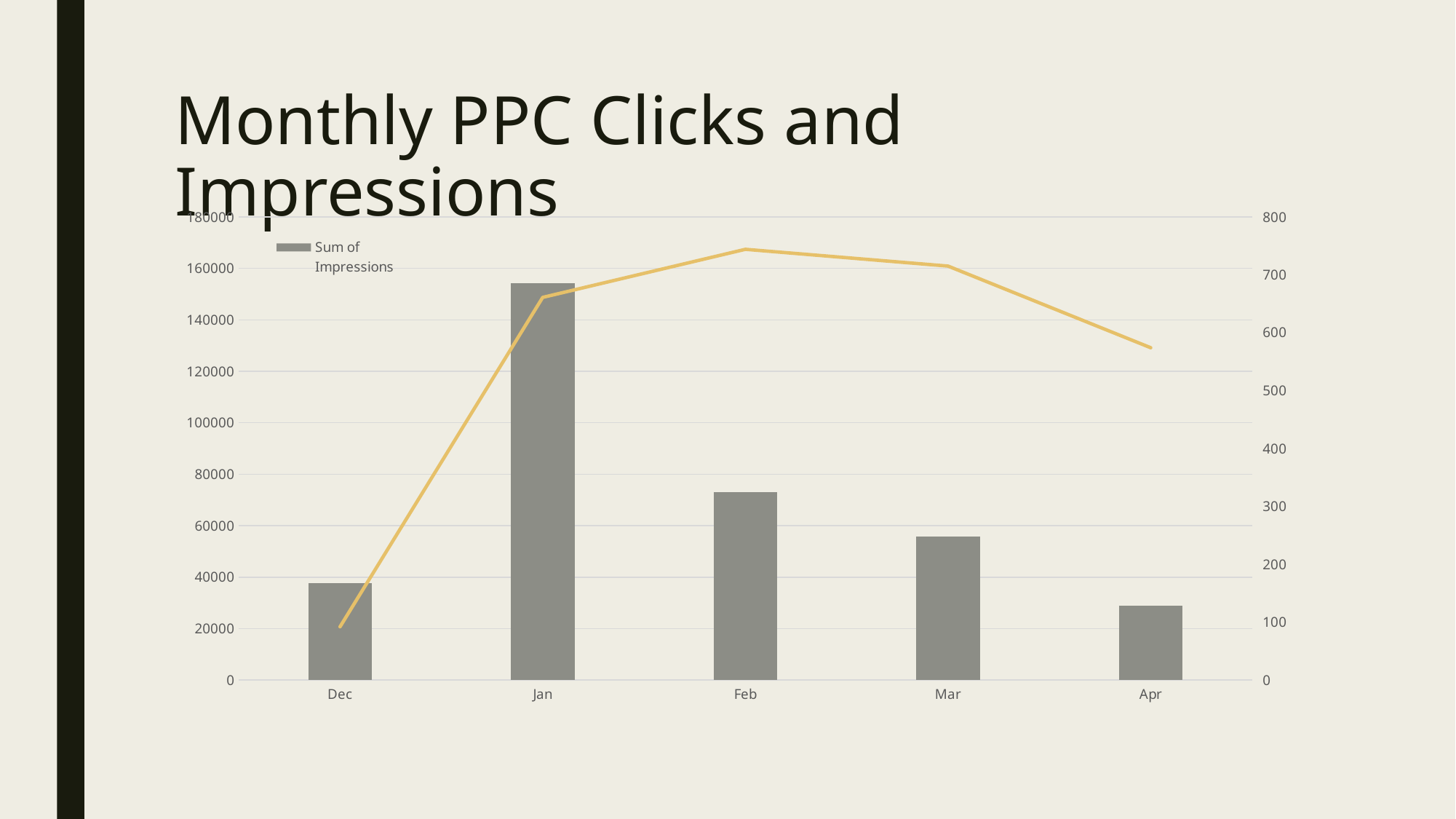
Which month has the lowest Sum of Impressions? Apr Is the Sum of Impressions for Feb greater or less than 80000? less Is the Sum of Impressions for Mar greater or less than 60000? less What kind of chart is shown on the slide? A bar chart with a line overlaid On the right-hand axis, is the line value for Feb greater or less than 700? greater How many series does the legend list? 1 Do the Sum of Impressions bars rise or fall from Jan to Apr? fall Which month has a larger Sum of Impressions, Feb or Mar? Feb How many months are shown on the x axis? 5 Which month has the highest Sum of Impressions? Jan